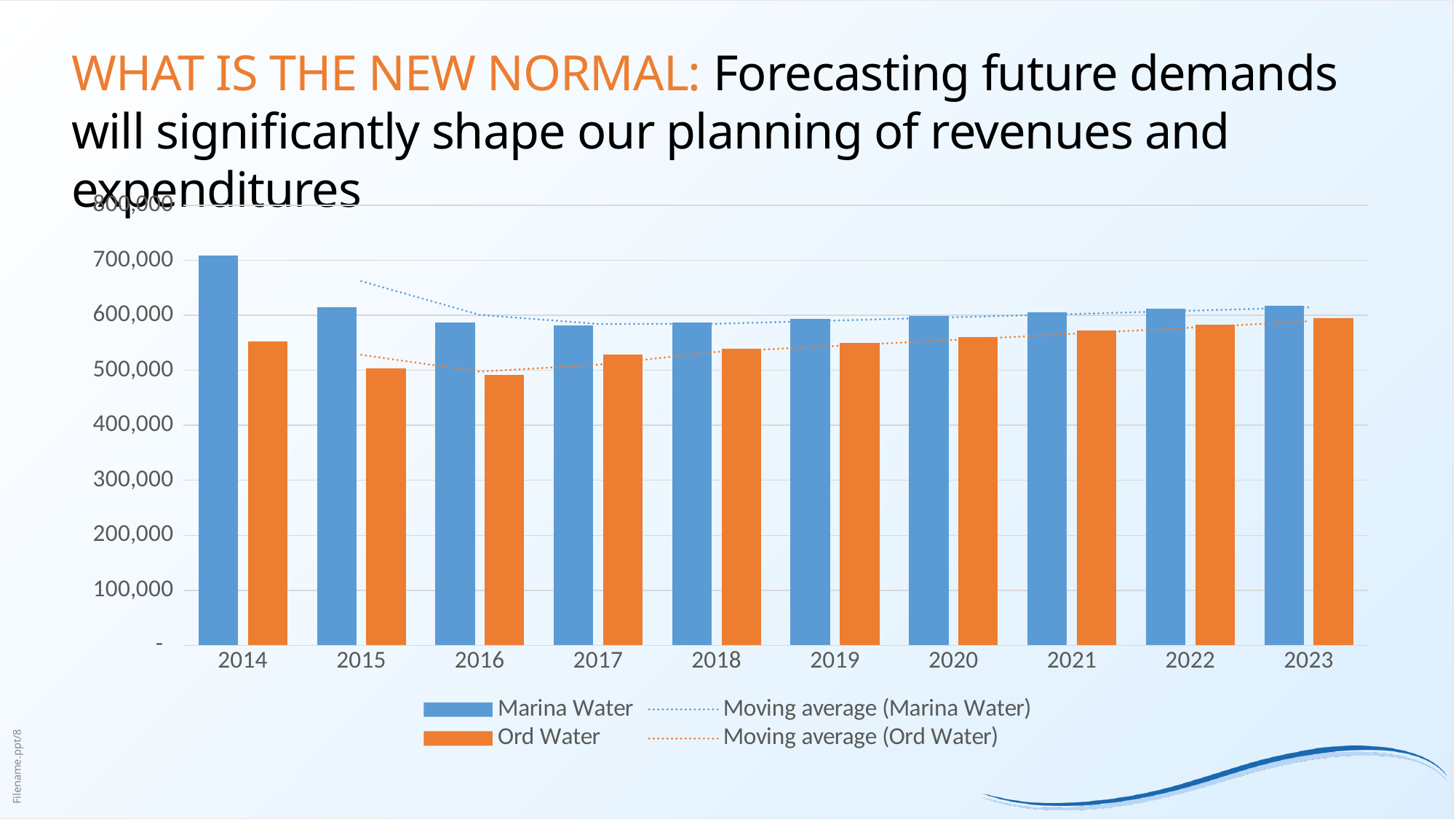
What kind of chart is shown on the slide? Bar chart Is the Marina Water value for 2014 greater or less than 700,000? greater Is the Marina Water value for 2015 greater or less than 600,000? greater How many years are shown on the x axis of the chart? 10 How many entries does the chart's legend list? 4 What colour are the Ord Water bars in the chart? Orange In 2014, which is larger: Marina Water or Ord Water? Marina Water Is the Ord Water value for 2016 greater or less than 500,000? less In which year is the Ord Water value lowest? 2016 In which year is the Marina Water value highest? 2014 Do the Ord Water values rise or fall from 2016 to 2023? rise